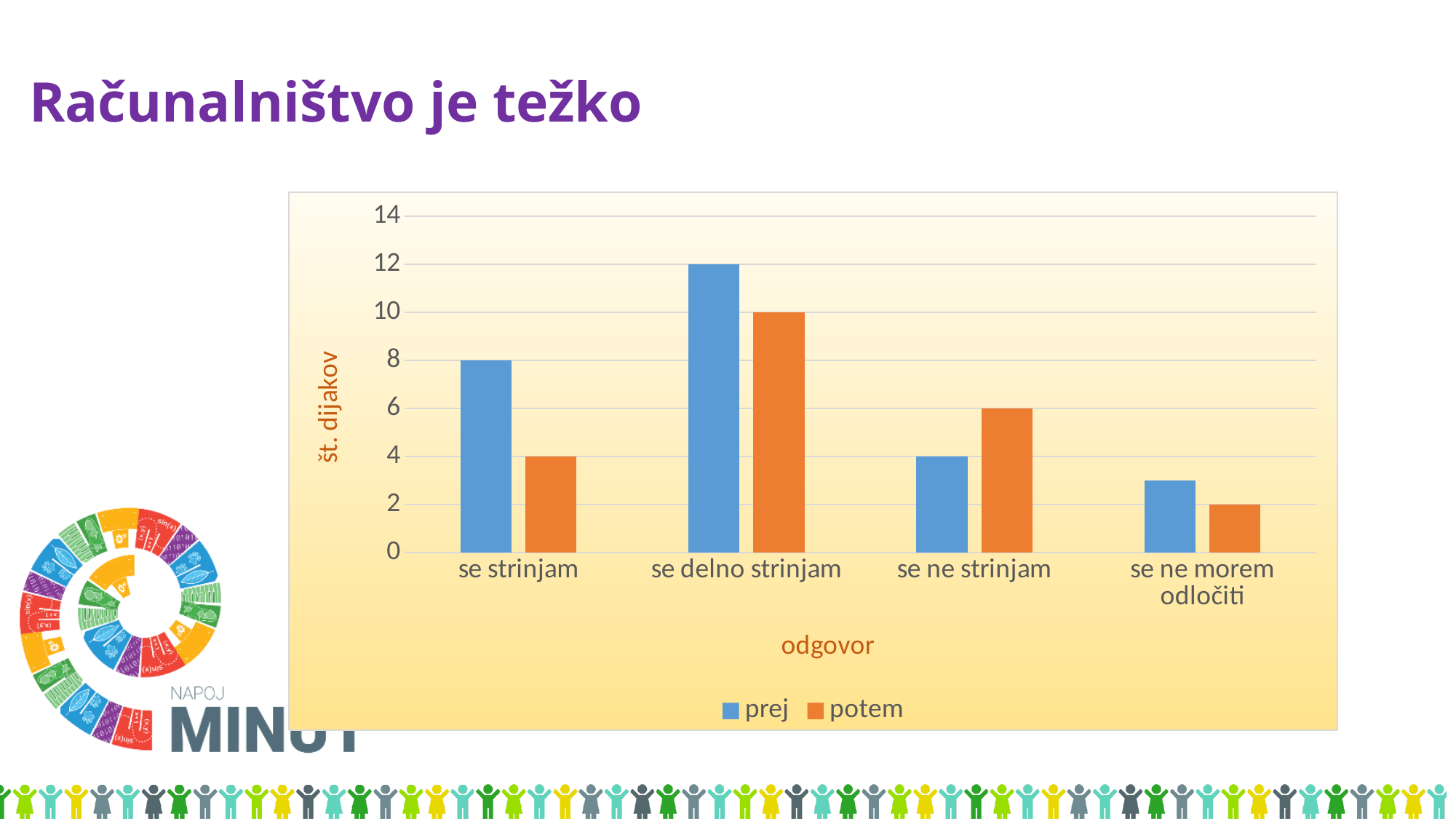
What is the difference between 'prej' and 'potem' for 'se strinjam'? 4 What is the value of 'potem' for 'se strinjam'? 4 How many answer categories are shown on the x axis? 4 Which category has the highest 'prej' value? se delno strinjam What is the value of 'prej' for 'se delno strinjam'? 12 Is the 'prej' value for 'se ne morem odločiti' greater or less than 4? less What kind of chart is shown on the slide? bar chart For 'se ne strinjam', which is larger, 'prej' or 'potem'? potem How many series does the legend list? 2 What is the label of the y axis? št. dijakov What is the value of 'potem' for 'se ne strinjam'? 6 Which category has the lowest 'potem' value? se ne morem odločiti